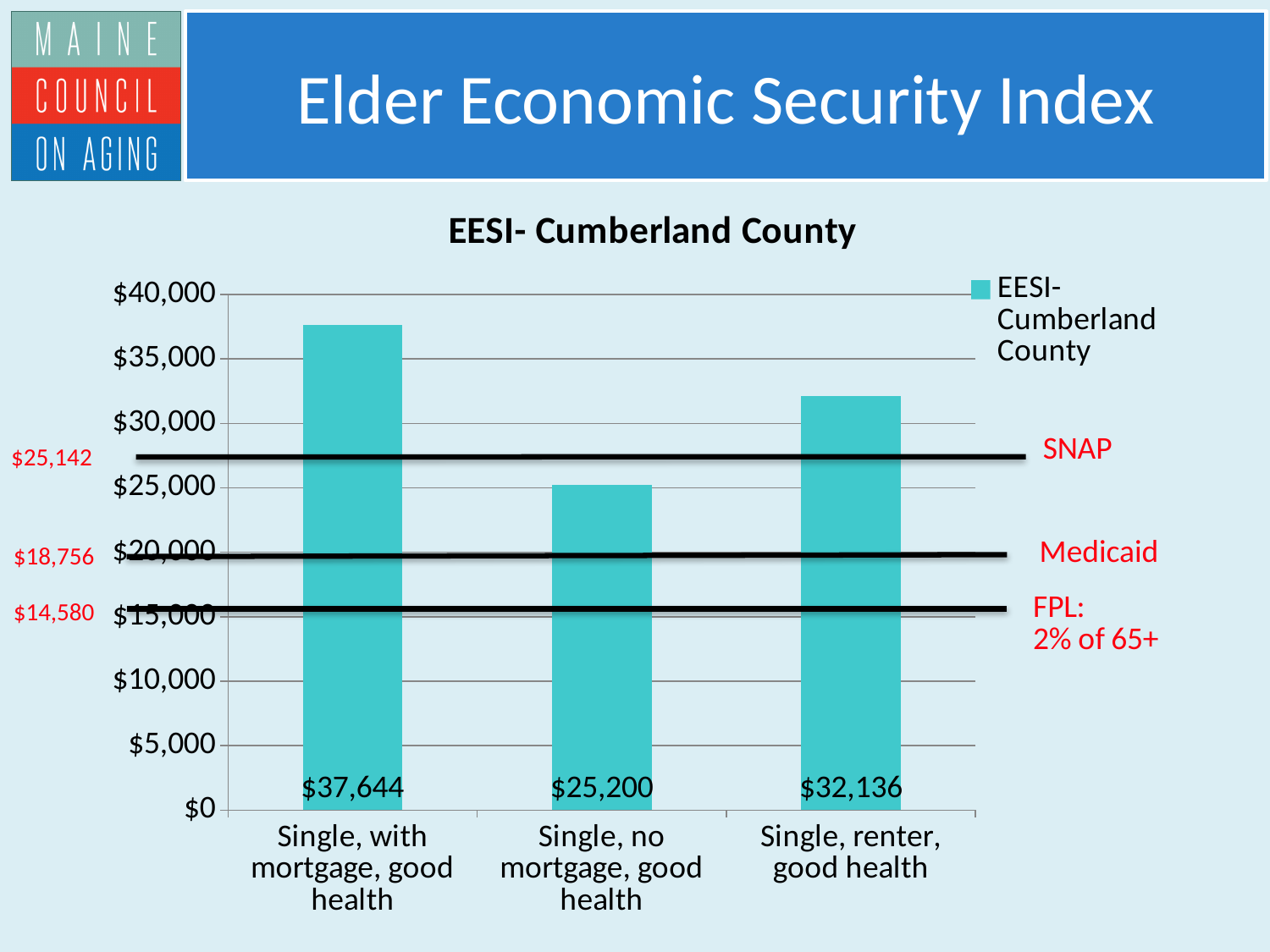
What kind of chart is shown on the slide? bar chart What is the EESI value for 'Single, no mortgage, good health'? $25,200 What is the EESI value for 'Single, renter, good health'? $32,136 Which category has the lowest EESI value? Single, no mortgage, good health How many categories are shown on the x axis? 3 What is the difference between the EESI values for 'Single, with mortgage, good health' and 'Single, no mortgage, good health'? $12,444 Is the value for 'Single, renter, good health' greater or less than $30,000? greater What is the title of the chart? EESI- Cumberland County What is the EESI value for 'Single, with mortgage, good health'? $37,644 What is the difference between the EESI values for 'Single, renter, good health' and 'Single, no mortgage, good health'? $6,936 Which is larger: the EESI value for 'Single, renter, good health' or for 'Single, no mortgage, good health'? Single, renter, good health Which category has the highest EESI value? Single, with mortgage, good health